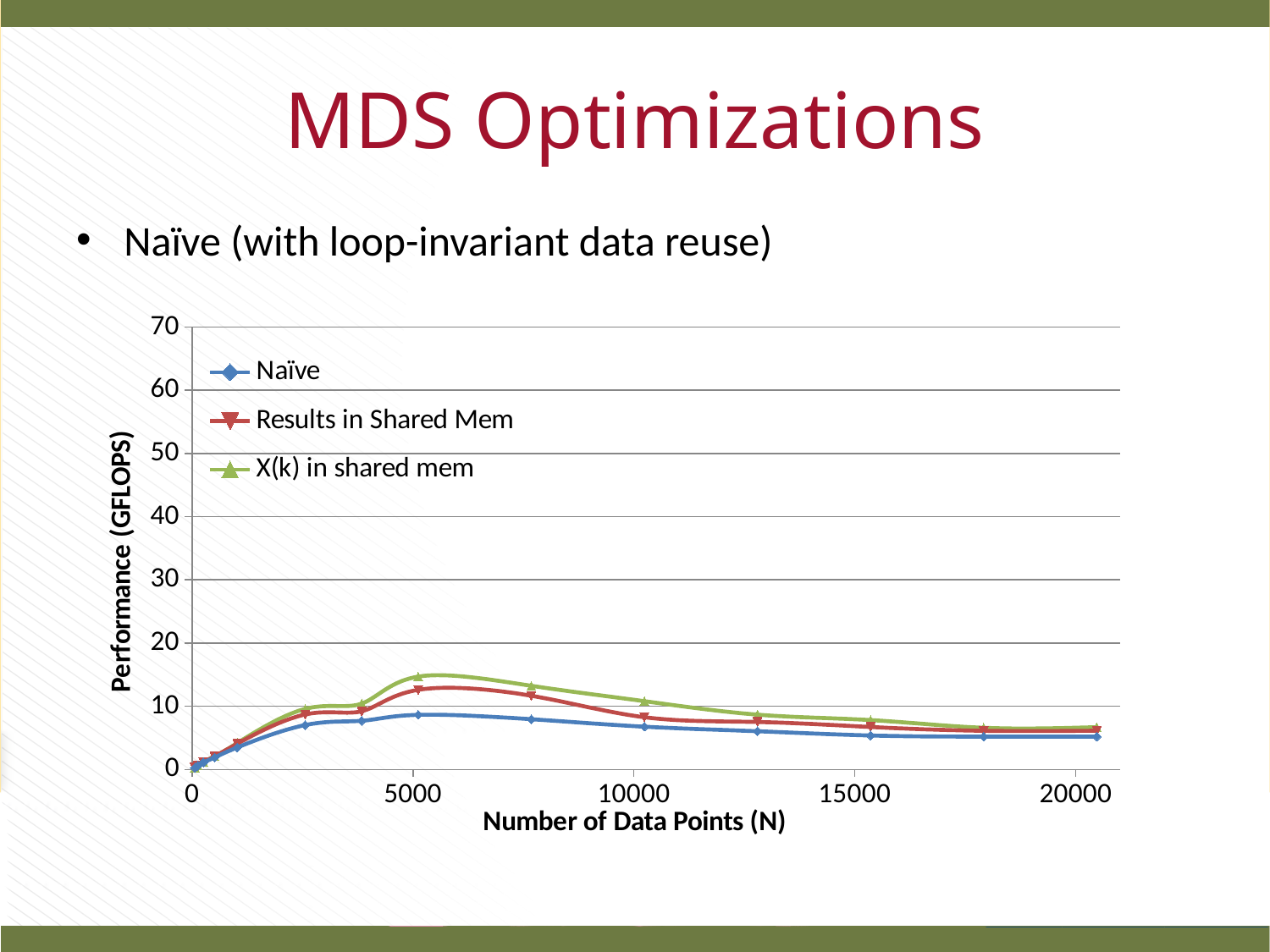
Is the value for Naïve at around 5000 data points greater or less than 10? less Which series has the lowest performance at around 5000 data points? Naïve What kind of chart is shown on the slide? line chart At around 5000 data points, which is larger: the value for X(k) in shared mem or the value for Naïve? X(k) in shared mem Is the value for X(k) in shared mem at around 5000 data points greater or less than 10? greater What is the title of the x axis? Number of Data Points (N) How many series does the legend list? 3 Which series reaches the highest performance at around 5000 data points? X(k) in shared mem Is the value for Results in Shared Mem at around 20000 data points greater or less than 10? less Do the values for X(k) in shared mem rise or fall between 5000 and 20000 data points? fall What is the title of the y axis? Performance (GFLOPS)